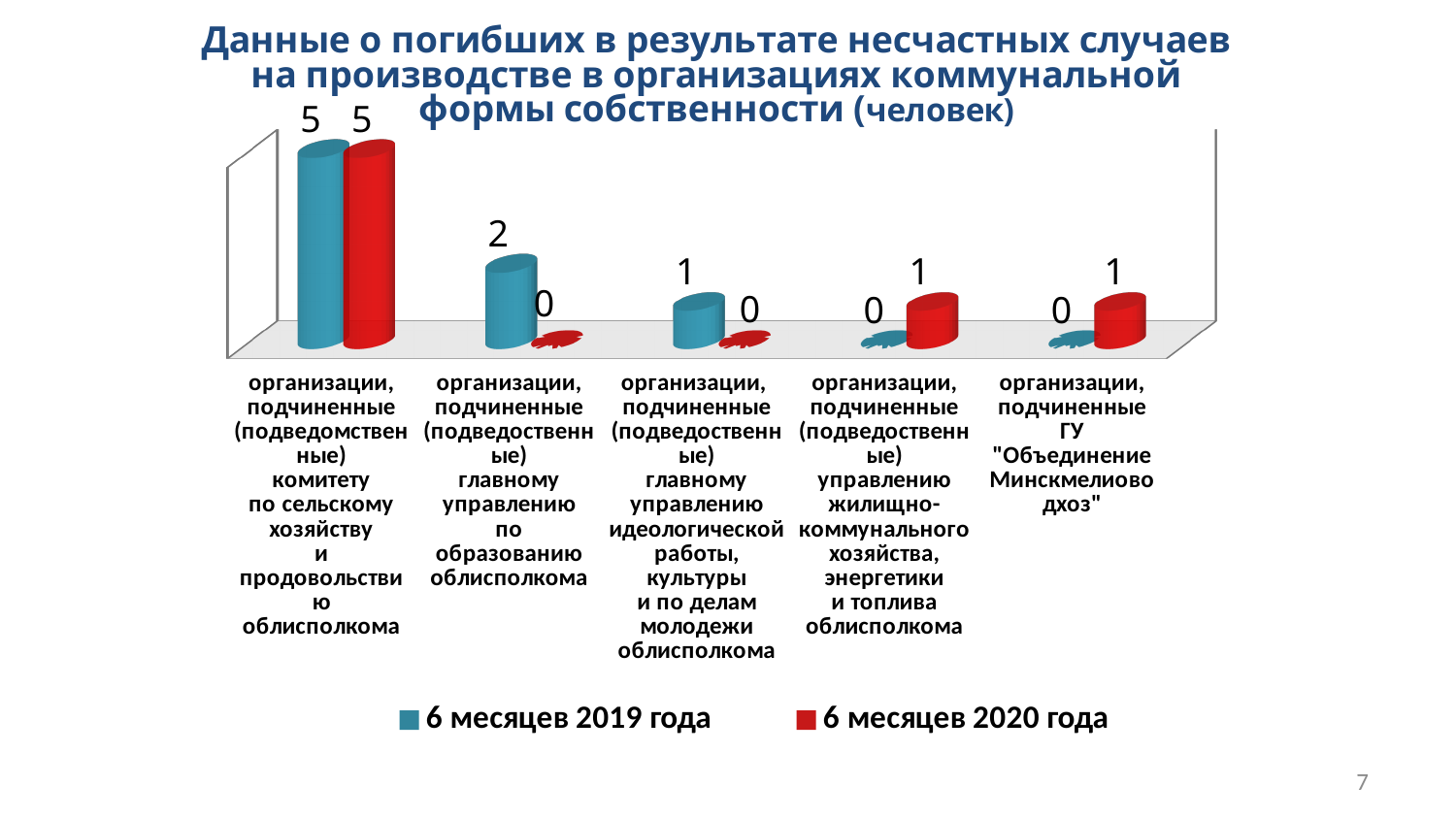
What is the total of the 2019 and 2020 values for organizations subordinate to the committee for agriculture and food (комитету по сельскому хозяйству и продовольствию облисполкома)? 10 What is the value for "6 месяцев 2019 года" for organizations subordinate to the main department of ideological work, culture and youth affairs (главному управлению идеологической работы, культуры и по делам молодежи облисполкома)? 1 Which category has the highest value for "6 месяцев 2019 года"? организации, подчиненные (подведомственные) комитету по сельскому хозяйству и продовольствию облисполкома What is the value for "6 месяцев 2020 года" for organizations subordinate to ГУ "Объединение Минскмелиоводхоз"? 1 What is the difference between the 2019 and 2020 values for organizations subordinate to the main department of education (главному управлению по образованию облисполкома)? 2 What is the value for "6 месяцев 2020 года" for organizations subordinate to the main department of education (главному управлению по образованию облисполкома)? 0 What is the value for "6 месяцев 2019 года" for organizations subordinate to the committee for agriculture and food (комитету по сельскому хозяйству и продовольствию облисполкома)? 5 How many series does the legend list? 2 Which colour represents the series "6 месяцев 2020 года" in the legend? red For organizations subordinate to the housing and utilities, energy and fuel department (управлению жилищно-коммунального хозяйства, энергетики и топлива облисполкома), which series has the larger value: "6 месяцев 2019 года" or "6 месяцев 2020 года"? 6 месяцев 2020 года What type of chart is shown on the slide? bar chart How many categories are shown on the x axis? 5